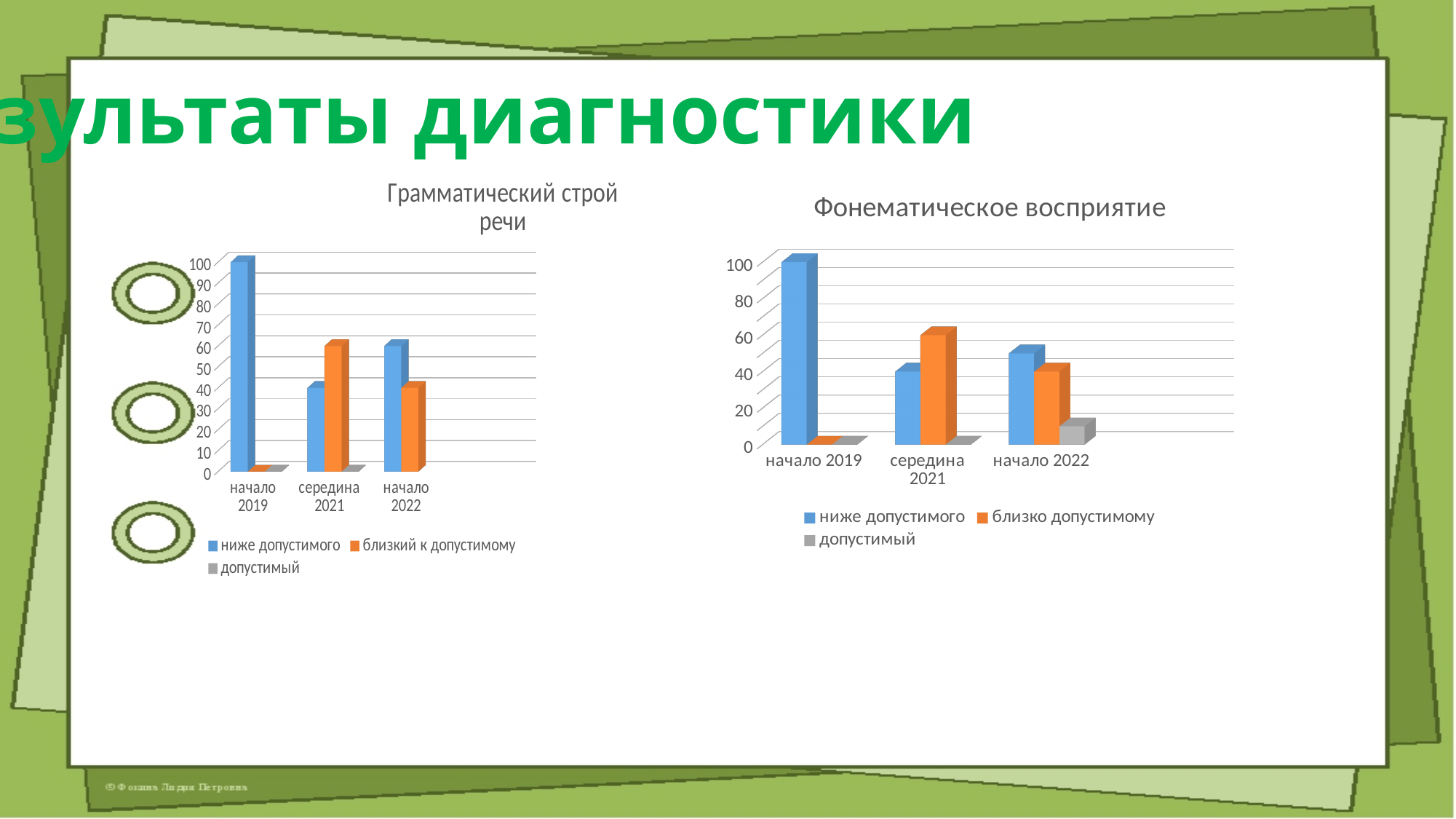
In the 'Грамматический строй речи' chart, which series is larger at 'начало 2022': 'ниже допустимого' or 'близкий к допустимому'? ниже допустимого In the 'Грамматический строй речи' chart, which category has the highest value for 'ниже допустимого'? начало 2019 How many series does the legend of the 'Фонематическое восприятие' chart list? 3 In the 'Фонематическое восприятие' chart, is the value for 'допустимый' at 'начало 2022' greater or less than 20? less In the 'Фонематическое восприятие' chart, does the 'ниже допустимого' series rise or fall from 'начало 2019' to 'середина 2021'? fall What type of chart is the 'Грамматический строй речи' chart? bar chart In the 'Грамматический строй речи' chart, is the value for 'близкий к допустимому' at 'середина 2021' greater or less than 50? greater In the 'Фонематическое восприятие' chart, which series is larger at 'середина 2021': 'ниже допустимого' or 'близко допустимому'? близко допустимому What colour represents the 'допустимый' series in the 'Фонематическое восприятие' chart? grey In the 'Фонематическое восприятие' chart, is the value for 'ниже допустимого' at 'середина 2021' greater or less than 60? less How many categories are shown on the x axis of the 'Грамматический строй речи' chart? 3